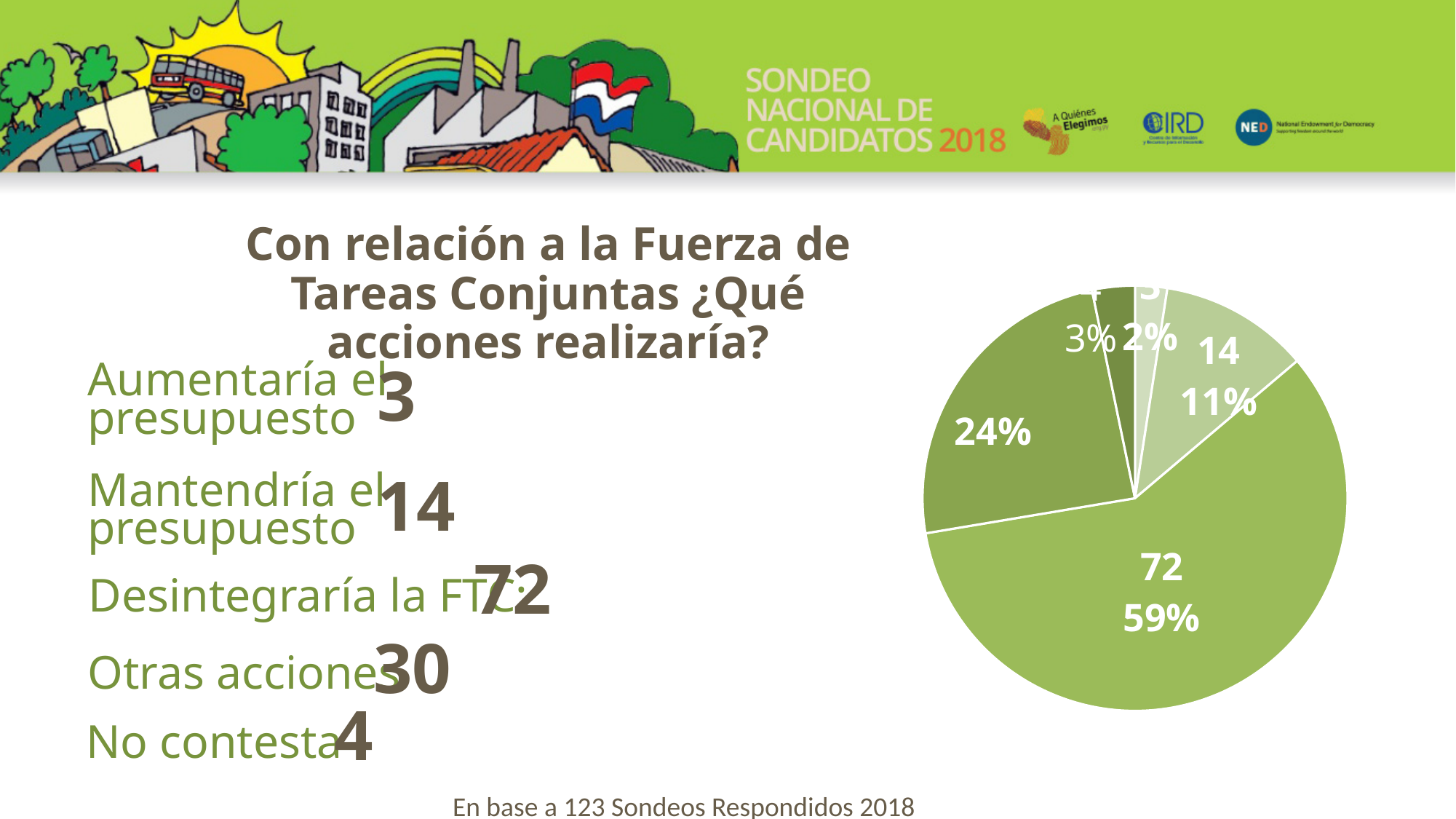
Which is larger on the pie chart, the slice labelled 24% or the slice labelled 11%? 24% What count is printed on the largest slice of the pie chart? 72 How many respondents chose 'Otras acciones'? 30 How many respondents chose 'Desintegraría la FTC'? 72 How many slices does the pie chart have? 5 What kind of chart is shown on the slide? pie chart How many respondents chose 'Mantendría el presupuesto'? 14 What is the difference between the counts for 'Desintegraría la FTC' and 'Mantendría el presupuesto'? 58 What percentage share is shown for the slice labelled 14? 11% According to the note at the bottom of the slide, how many surveys were answered? 123 What percentage share is shown for the largest slice of the pie chart? 59% What is the smallest percentage share printed on the pie chart? 2%